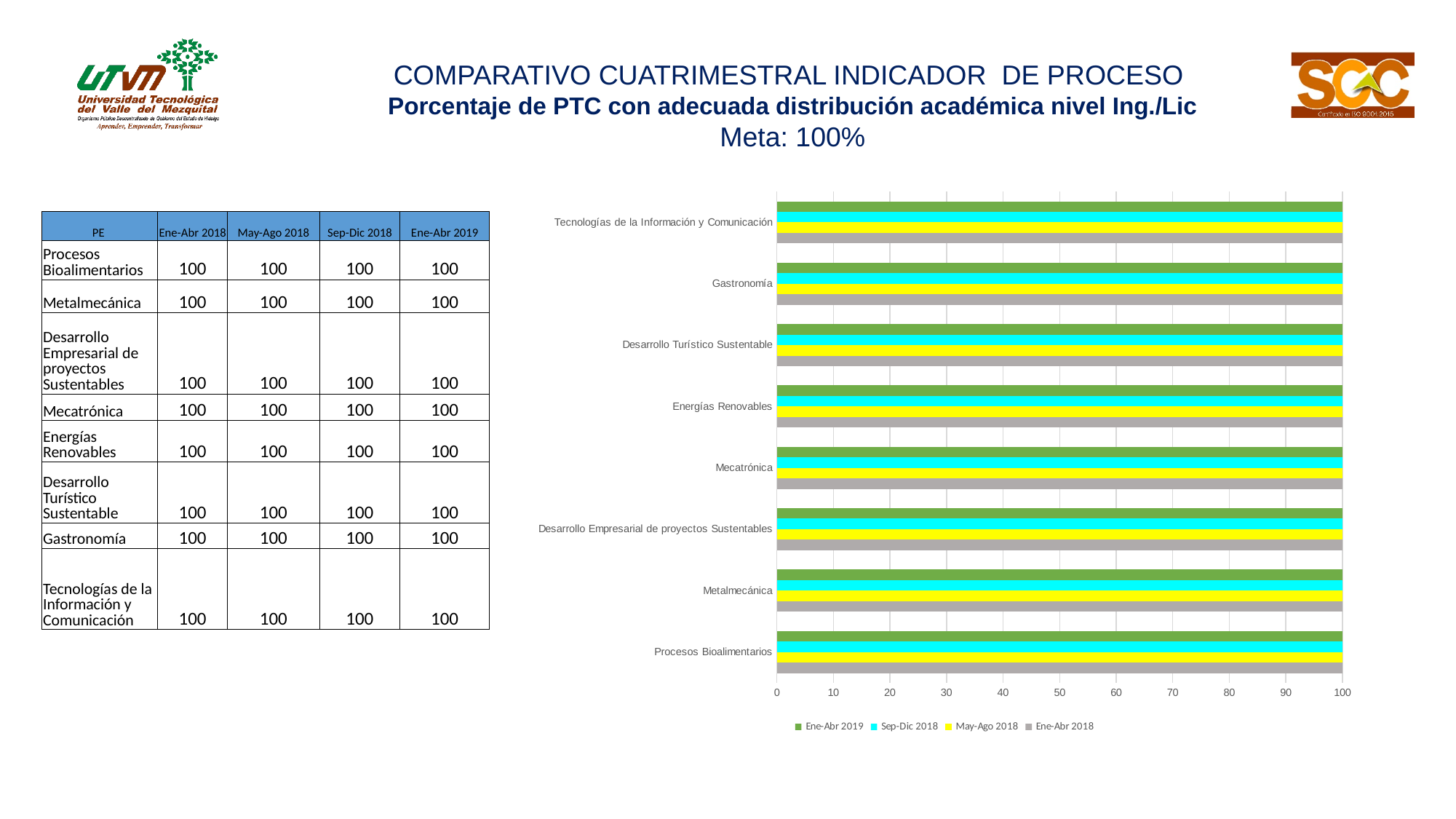
What is the value for Mecatrónica in the Sep-Dic 2018 series? 100 Which series is shown in yellow in the chart legend? May-Ago 2018 How many series does the chart legend list? 4 Is the value for Energías Renovables in the Ene-Abr 2019 series greater or less than 90? greater What is the value for Gastronomía in the Ene-Abr 2019 series? 100 What is the value for Metalmecánica in the May-Ago 2018 series? 100 Do the values for Tecnologías de la Información y Comunicación change across the four periods? No, all are 100 What is the difference between the Ene-Abr 2019 value and the Ene-Abr 2018 value for Desarrollo Turístico Sustentable? 0 What is the highest value shown on the chart's horizontal axis? 100 What kind of chart is shown on the slide? bar chart How many programs (categories) are plotted on the chart? 8 What is the value for Procesos Bioalimentarios in the Ene-Abr 2018 series? 100